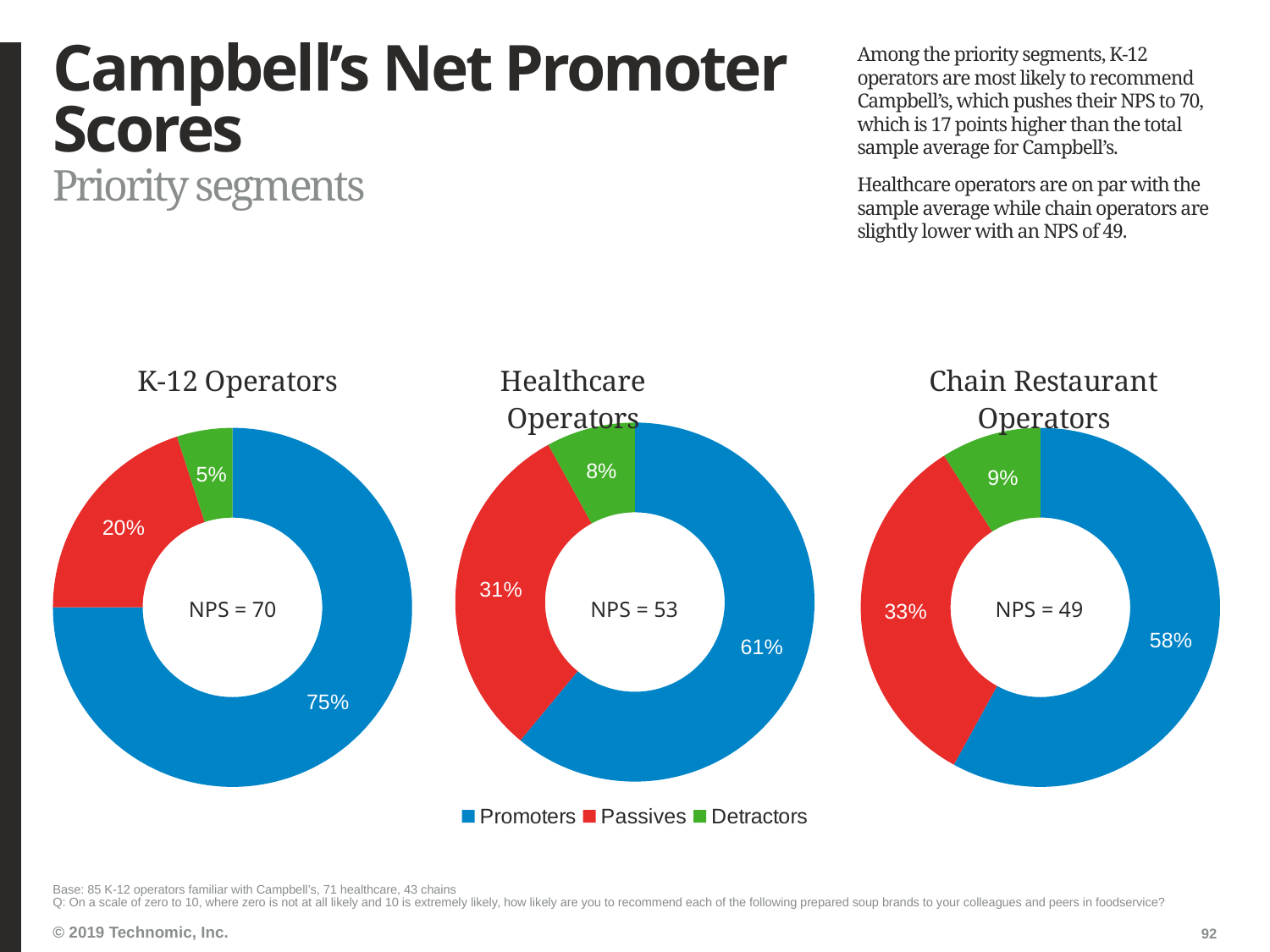
Which colour represents Passives in the legend? Red How many doughnut charts are shown on the slide? 3 In the Chain Restaurant Operators chart, what percentage are Detractors? 9% In the Healthcare Operators chart, what is the difference between the Promoters and Passives percentages? 30% In the K-12 Operators chart, which category has the smallest share? Detractors What kind of chart is used for the K-12 Operators data? Doughnut chart Is the Promoters share larger in the K-12 Operators chart or the Chain Restaurant Operators chart? K-12 Operators In the Chain Restaurant Operators chart, which category has the largest share? Promoters In the K-12 Operators chart, what percentage are Promoters? 75% How many series does the legend list? 3 In the Healthcare Operators chart, what is the NPS shown in the centre? NPS = 53 In the Healthcare Operators chart, what percentage are Passives? 31%